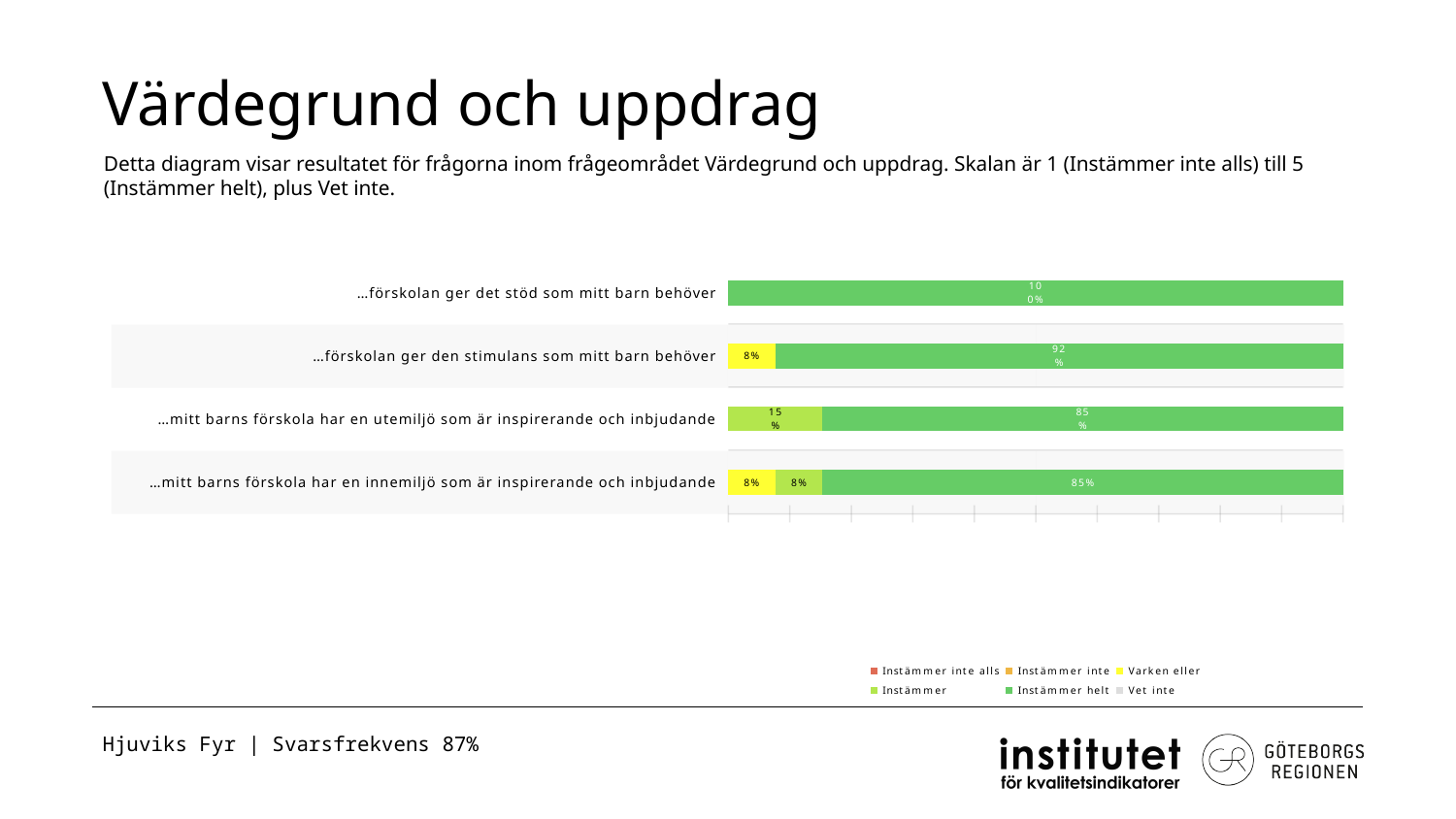
What is the 'Varken eller' value for '…mitt barns förskola har en innemiljö som är inspirerande och inbjudande'? 8% Which category has the highest 'Instämmer helt' share? …förskolan ger det stöd som mitt barn behöver How many series does the legend list? 6 What is the 'Instämmer' value for '…mitt barns förskola har en utemiljö som är inspirerande och inbjudande'? 15% What is the 'Instämmer helt' value for '…förskolan ger den stimulans som mitt barn behöver'? 92% What is the difference between the 'Instämmer helt' values for '…förskolan ger den stimulans som mitt barn behöver' and '…mitt barns förskola har en utemiljö som är inspirerande och inbjudande'? 7% Which is larger: the 'Instämmer' value for the utemiljö question or the 'Instämmer' value for the innemiljö question? The utemiljö question (15%) What is the 'Instämmer helt' value for '…mitt barns förskola har en utemiljö som är inspirerande och inbjudande'? 85% How many categories (questions) are plotted in the chart? 4 Which legend entry is shown in yellow? Varken eller What is the 'Instämmer helt' value for '…förskolan ger det stöd som mitt barn behöver'? 100% What kind of chart is shown on the slide? Stacked bar chart